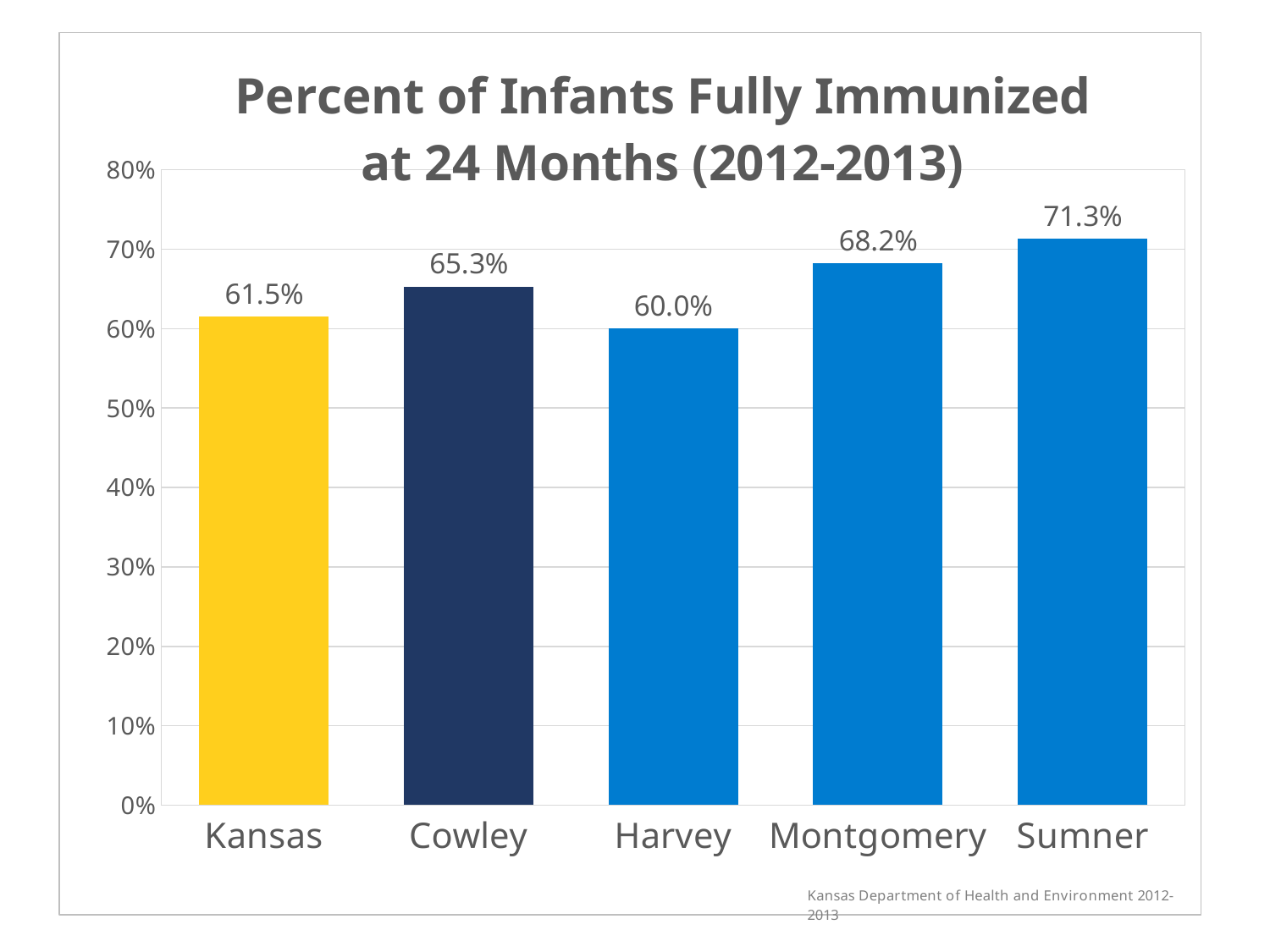
What is the difference in percentage points between Cowley and Kansas? 3.8 How many categories are shown on the x axis? 5 What is the difference in percentage points between Sumner and Harvey? 11.3 What is the title of the chart? Percent of Infants Fully Immunized at 24 Months (2012-2013) What is the value shown for Montgomery? 68.2% What is the percent of infants fully immunized at 24 months for Cowley? 65.3% Which category has the lowest percent of infants fully immunized? Harvey Is the value for Sumner greater or less than 70%? greater Which has a higher value, Montgomery or Cowley? Montgomery What kind of chart is shown on the slide? Bar chart Which category has the highest percent of infants fully immunized? Sumner What is the value shown for Kansas? 61.5%